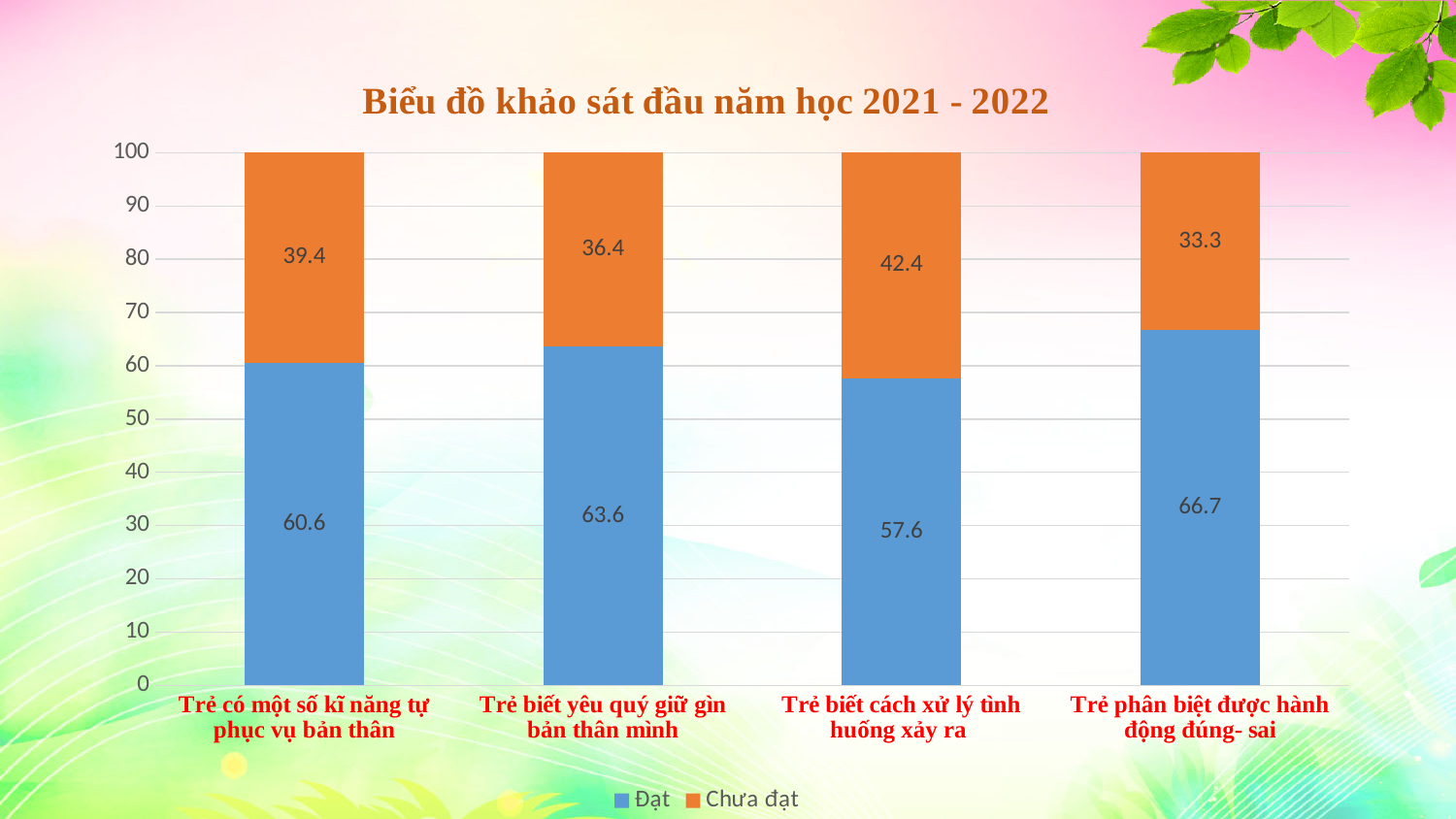
Which is larger: the "Chưa đạt" value for "Trẻ có một số kĩ năng tự phục vụ bản thân" or for "Trẻ biết yêu quý giữ gìn bản thân mình"? Trẻ có một số kĩ năng tự phục vụ bản thân How many categories are shown on the x axis? 4 How many series does the legend list? 2 What type of chart is shown on the slide? Stacked bar chart What is the value of "Đạt" for "Trẻ có một số kĩ năng tự phục vụ bản thân"? 60.6 Which category has the lowest "Đạt" value? Trẻ biết cách xử lý tình huống xảy ra What is the difference between the "Đạt" values for "Trẻ phân biệt được hành động đúng- sai" and "Trẻ biết cách xử lý tình huống xảy ra"? 9.1 Which category has the highest "Đạt" value? Trẻ phân biệt được hành động đúng- sai What is the total of the stacked bar for "Trẻ biết yêu quý giữ gìn bản thân mình"? 100 What is the value of "Chưa đạt" for "Trẻ biết yêu quý giữ gìn bản thân mình"? 36.4 What is the value of "Chưa đạt" for "Trẻ biết cách xử lý tình huống xảy ra"? 42.4 What is the value of "Đạt" for "Trẻ phân biệt được hành động đúng- sai"? 66.7